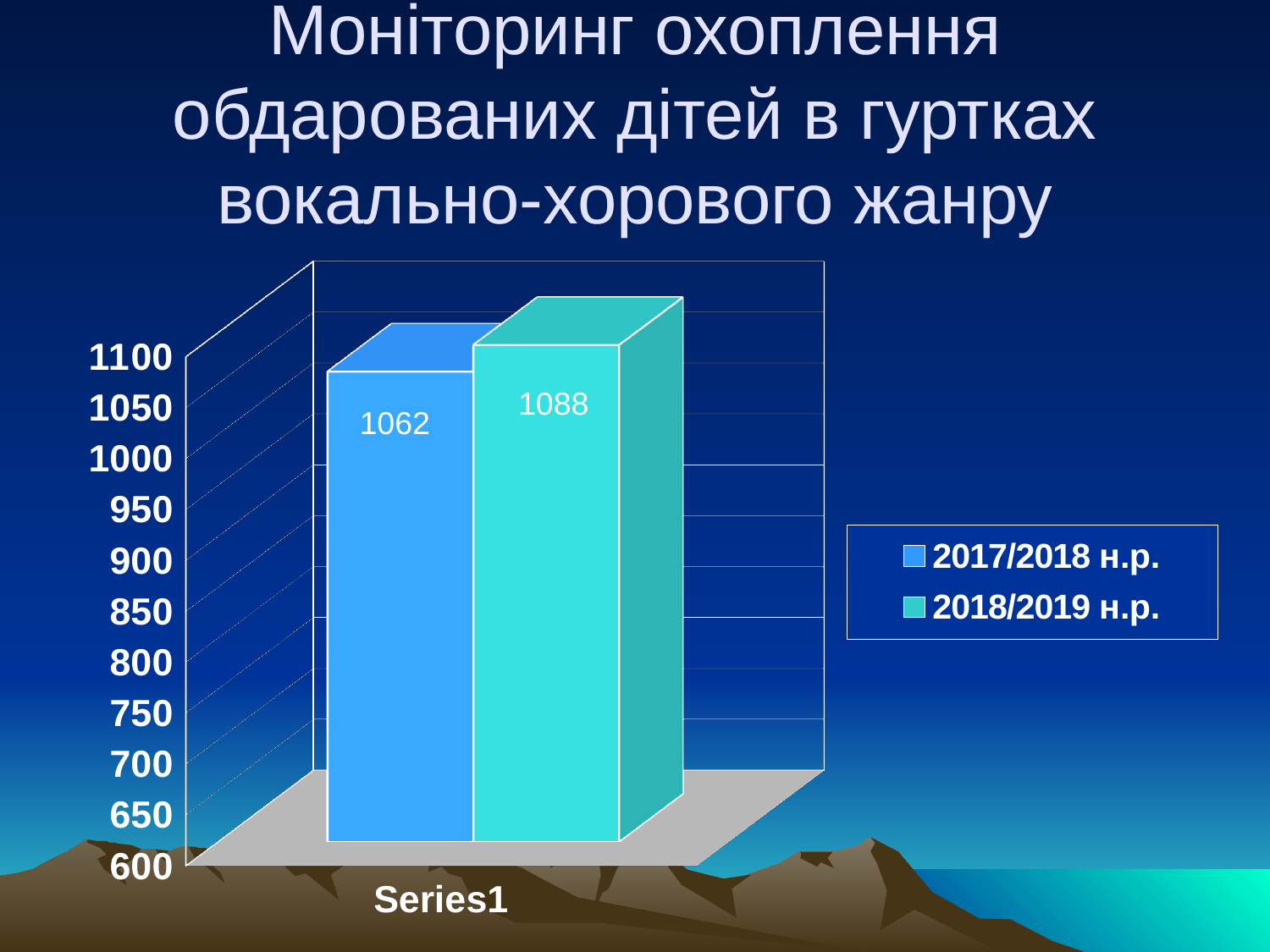
Is the value for 2017/2018 н.р. greater or less than 1000? greater What is the value for 2017/2018 н.р.? 1062 Is the value for 2018/2019 н.р. greater or less than 1100? less Which series has the higher value, 2017/2018 н.р. or 2018/2019 н.р.? 2018/2019 н.р. How many series does the legend list? 2 What kind of chart is shown on the slide? bar chart What is the label on the x axis under the bars? Series1 Which series has the highest value? 2018/2019 н.р. What is the value for 2018/2019 н.р.? 1088 Which series has the lowest value? 2017/2018 н.р. What is the highest value shown on the vertical axis? 1100 What is the difference between the values for 2018/2019 н.р. and 2017/2018 н.р.? 26